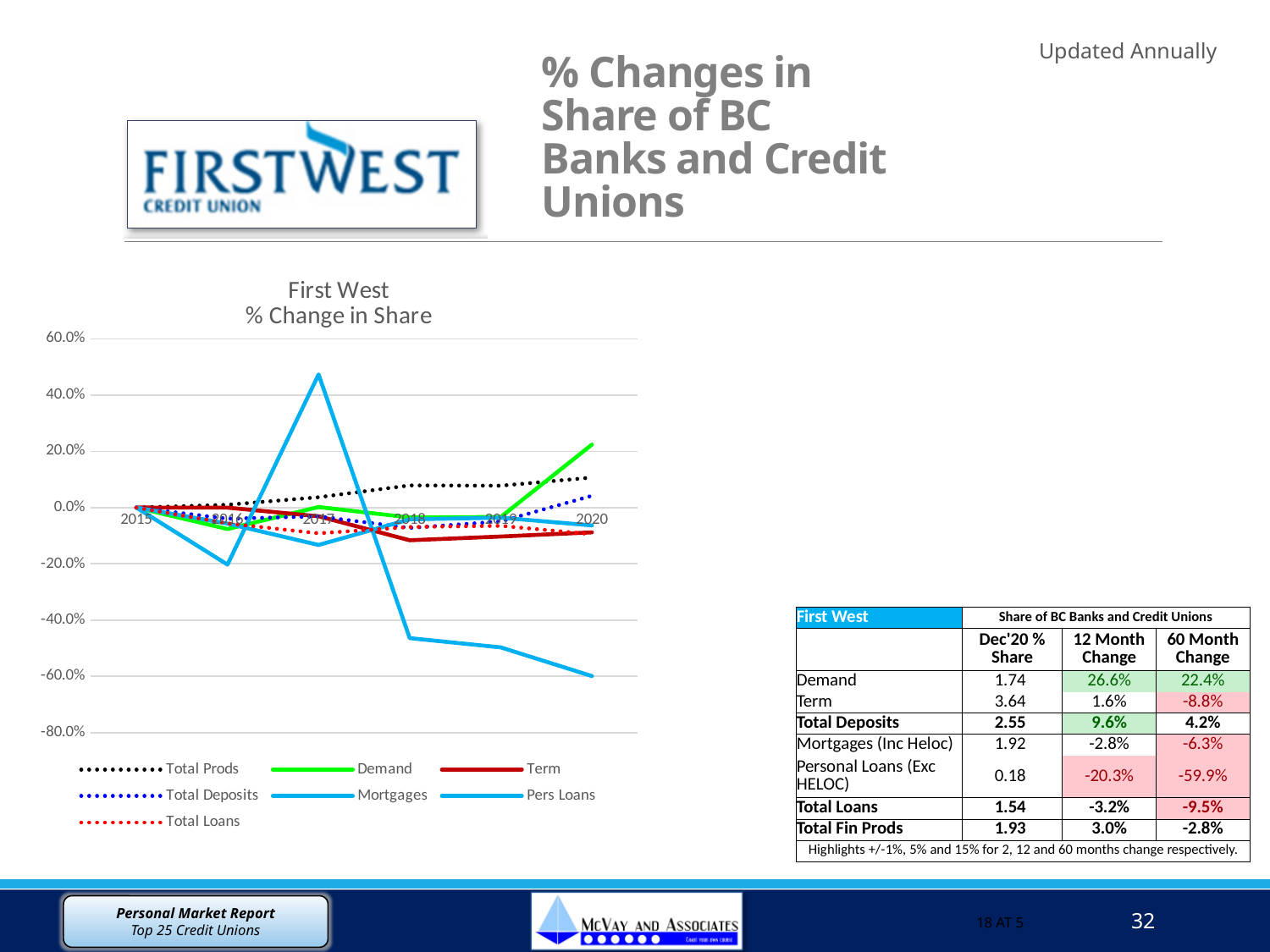
Which series has the highest value in 2020? Demand How many series does the chart legend list? 7 Which series reaches the highest point anywhere on the chart? Pers Loans Which series has the lowest value in 2020? Pers Loans Is the value for Pers Loans in 2017 greater or less than 40.0%? greater Is the value for Pers Loans in 2020 greater or less than -40.0%? less What type of chart is shown on the slide? Line chart How many years are shown along the x axis of the chart? 6 What is the title of the chart? First West % Change in Share Is the value for Demand in 2020 greater or less than 10.0%? greater Which colour is used for the Demand series in the chart? Green Does the Pers Loans line rise or fall from 2018 to 2020? Fall